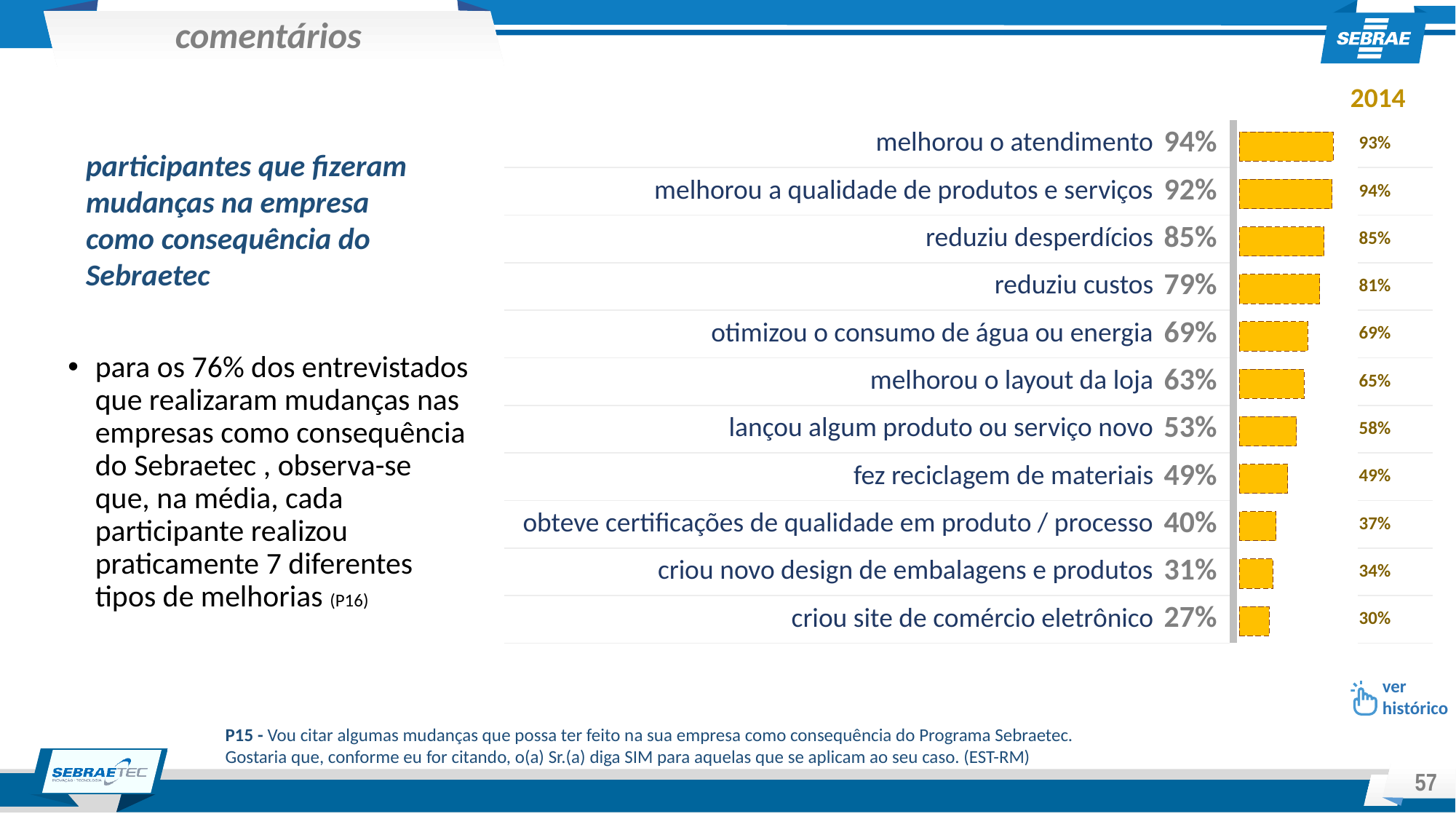
What year is shown as the comparison column to the right of the bars? 2014 What is the difference between the values for "reduziu desperdícios" and "reduziu custos"? 6% Which category has the highest value in the bar chart? melhorou o atendimento By how much did the value for "criou novo design de embalagens e produtos" change from 2014 to the current value? decreased by 3% What type of chart is shown on the slide? bar chart How many categories are shown in the bar chart? 11 What is the value shown for "reduziu custos"? 79% What percentage of participants reported "melhorou o atendimento"? 94% Which is larger: the value for "fez reciclagem de materiais" or for "obteve certificações de qualidade em produto / processo"? fez reciclagem de materiais What was the 2014 value for "lançou algum produto ou serviço novo"? 58% What is the value shown for "criou site de comércio eletrônico"? 27% Which category has the lowest value in the bar chart? criou site de comércio eletrônico